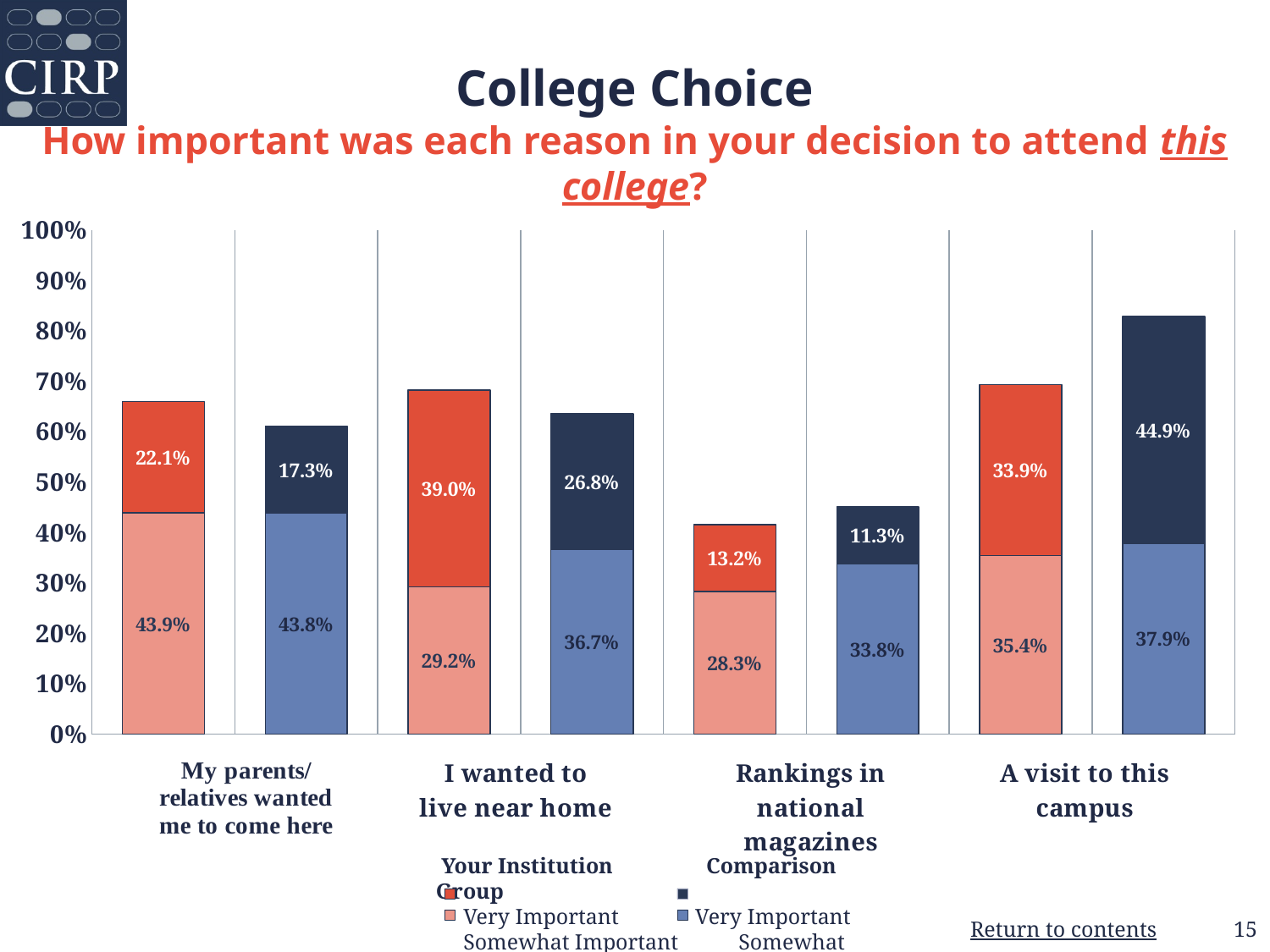
What type of chart is shown on the slide? Stacked bar chart What is the combined Very Important and Somewhat Important total for Your Institution for "Rankings in national magazines"? 41.5% How many reasons (categories) are shown on the x axis? 4 What percentage of Your Institution students rated "A visit to this campus" as Very Important? 33.9% Which reason has the highest Very Important percentage for the Comparison Group? A visit to this campus What is the difference between the Very Important percentages for Your Institution and the Comparison Group for "My parents/relatives wanted me to come here"? 4.8% Which reason has the lowest Very Important percentage for Your Institution? Rankings in national magazines What percentage of Your Institution students rated "I wanted to live near home" as Very Important? 39.0% What percentage of the Comparison Group rated "Rankings in national magazines" as Somewhat Important? 33.8% For "I wanted to live near home", which group has the larger Very Important percentage, Your Institution or the Comparison Group? Your Institution Is the total height of the Comparison Group bar for "A visit to this campus" greater or less than 80%? greater